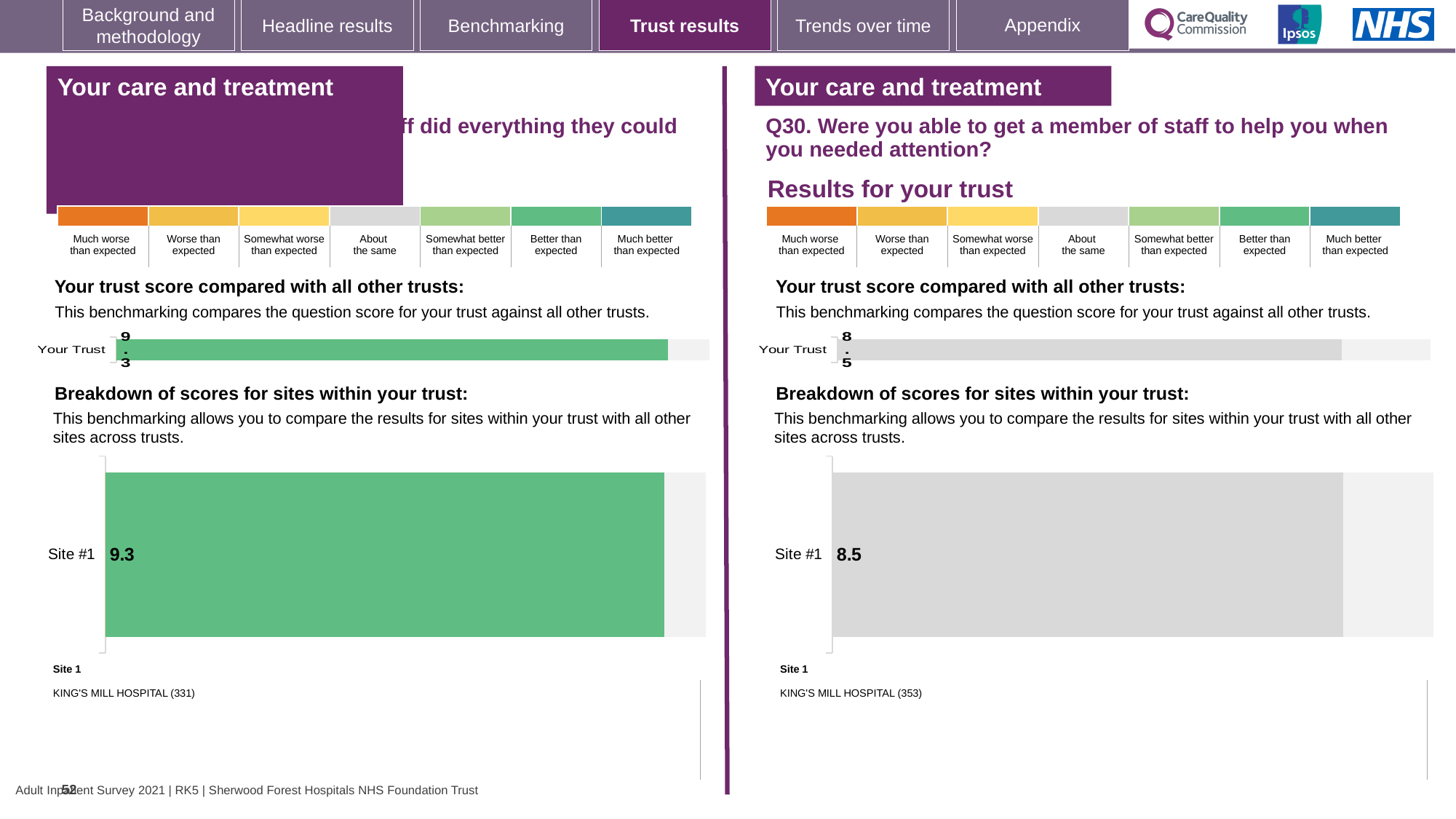
How many sites are shown in the site breakdown chart on the left half of the slide? 1 On the right half of the slide (Q30), what is the score shown for Site #1? 8.5 What is the name of Site 1 listed under the site breakdown chart on the right half of the slide (Q30)? KING'S MILL HOSPITAL (353) On the left half of the slide, what is the score shown for Your Trust in the trust comparison bar? 9.3 What colour is the Site #1 bar on the left half of the slide? Green On the left half of the slide, what is the score shown for Site #1? 9.3 On the right half of the slide (Q30), what is the score shown for Your Trust in the trust comparison bar? 8.5 How many sites are shown in the site breakdown chart on the right half of the slide (Q30)? 1 What kind of chart is used to show the Site #1 score on the right half of the slide (Q30)? Bar chart What is the difference between the Site #1 score on the left half of the slide and the Site #1 score on the right half (Q30)? 0.8 Which Site #1 score is larger: the one on the left half of the slide or the one on the right half (Q30)? Left half (9.3)